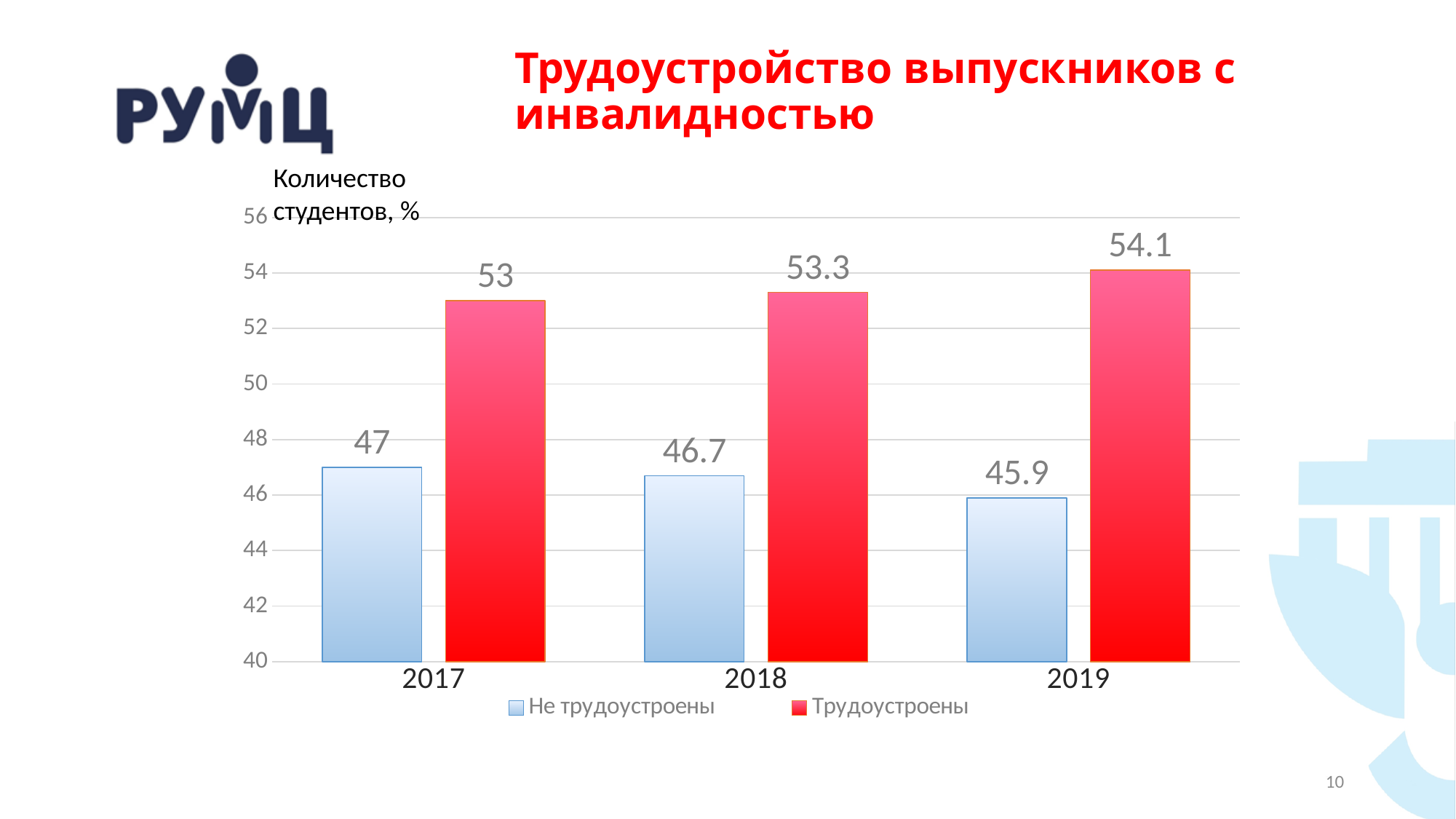
What is the value for Не трудоустроены in 2018? 46.7 What is the difference between the Трудоустроены and Не трудоустроены values in 2018? 6.6 How many years are shown on the x axis? 3 In which year is the Не трудоустроены value lowest? 2019 How many series does the legend list? 2 In which year is the Трудоустроены value highest? 2019 What is the value for Не трудоустроены in 2017? 47 Which is larger in 2017: Трудоустроены or Не трудоустроены? Трудоустроены What kind of chart is shown on the slide? Bar chart Do the Трудоустроены values rise or fall from 2017 to 2019? Rise What is the title of the slide? Трудоустройство выпускников с инвалидностью What is the value for Трудоустроены in 2019? 54.1